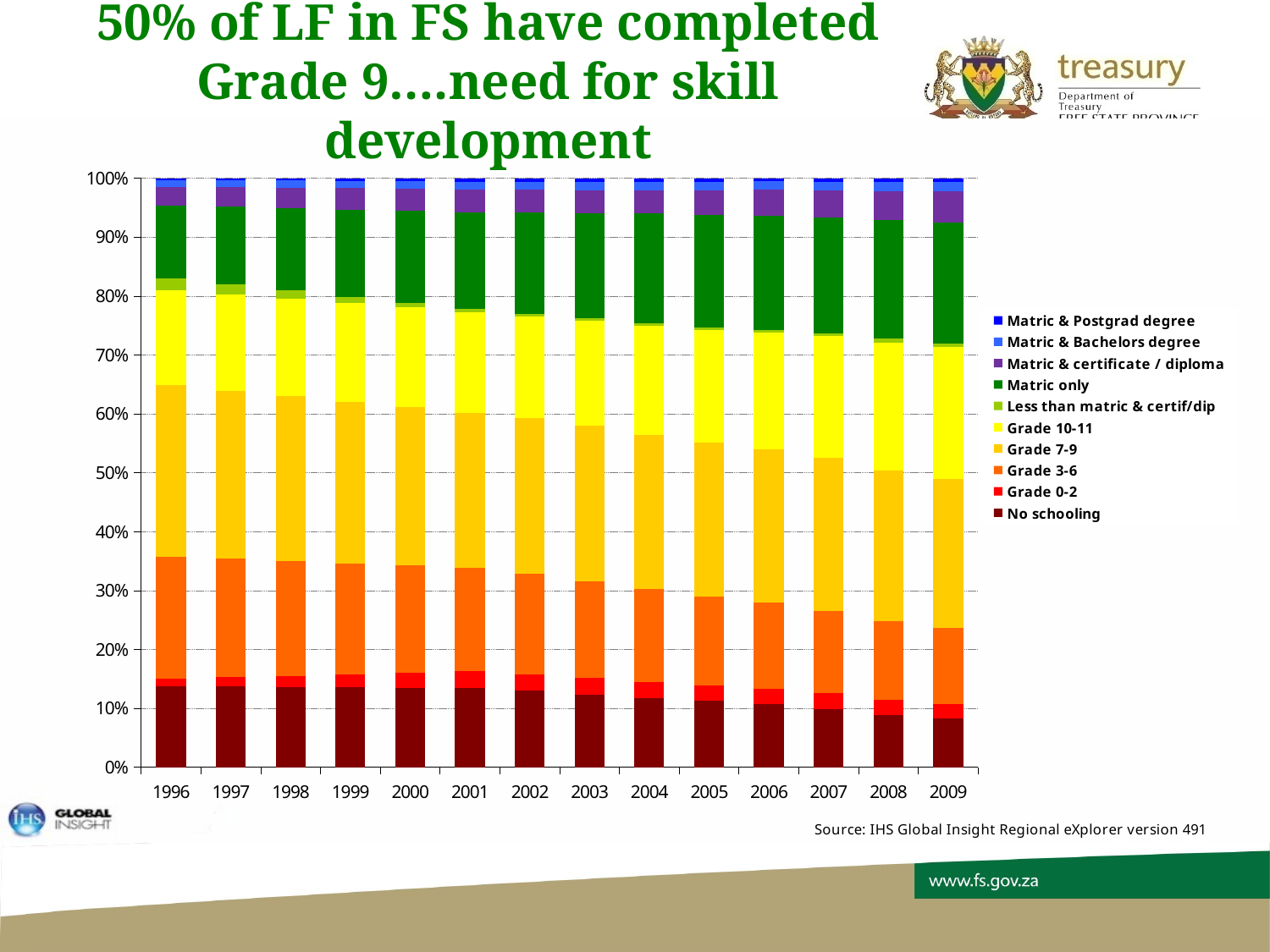
What does each stacked bar total? 100% Which year has the larger 'No schooling' share, 1996 or 2009? 1996 How many years are shown along the x axis of the chart? 14 Does the 'No schooling' share rise or fall from 1996 to 2009? fall Is the 'No schooling' share in 1996 greater or less than 10%? greater Which year has the larger 'Matric only' share, 1996 or 2009? 2009 How many series does the chart's legend list? 10 What is the last year shown on the x axis? 2009 What kind of chart is shown on the slide? Stacked bar chart Which legend entry is shown in dark green? Matric only Is the 'No schooling' share in 2009 greater or less than 10%? less What is the first year shown on the x axis? 1996